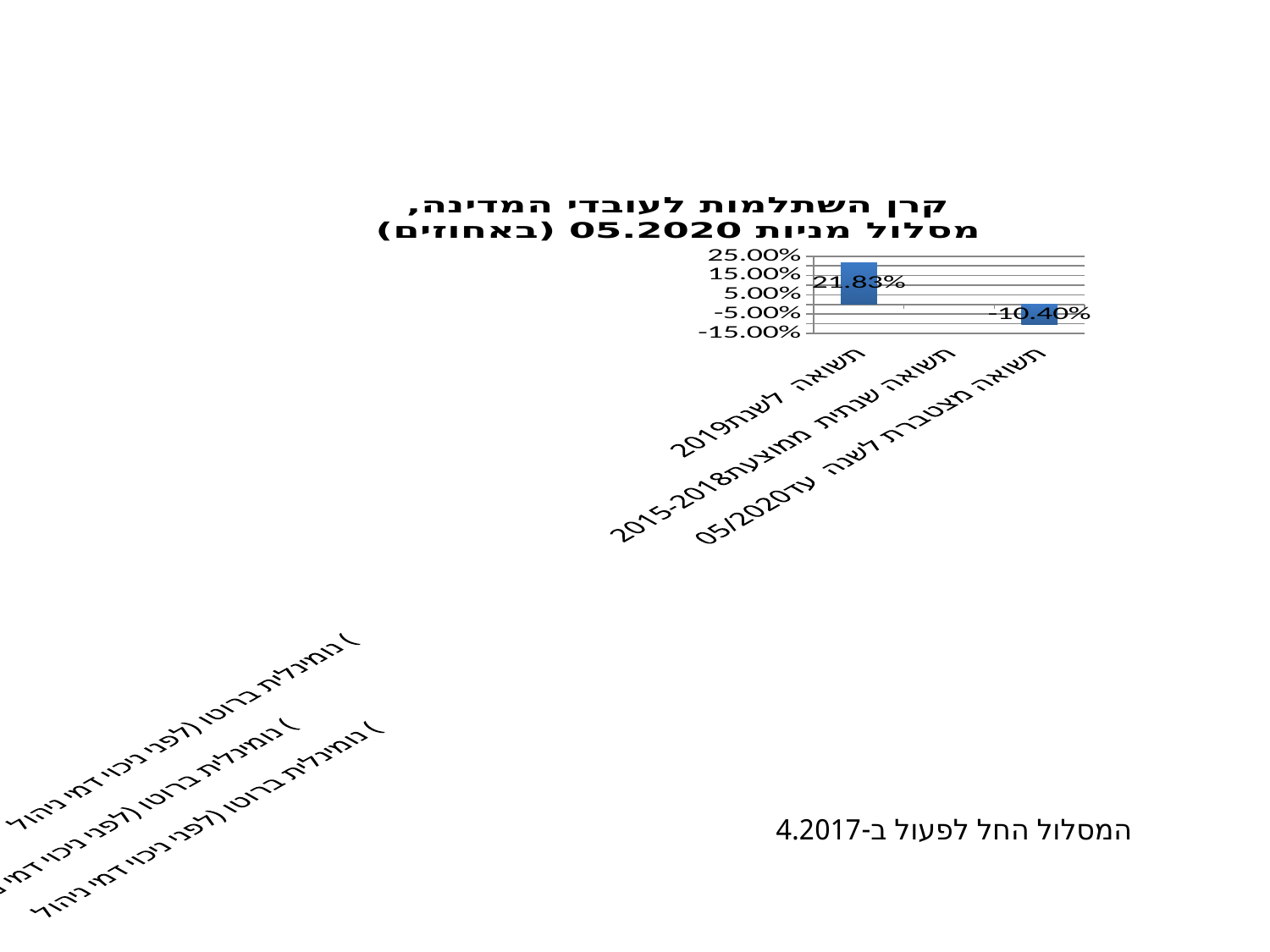
Is the value for תשואה מצטברת לשנה עד 05/2020 greater or less than -5.00%? less Which category has the lowest value in the chart? תשואה מצטברת לשנה עד 05/2020 What kind of chart is shown on the slide? bar chart What is the title of the chart? קרן השתלמות לעובדי המדינה, מסלול מניות 05.2020 (באחוזים) Which is larger: the value for תשואה לשנת 2019 or the value for תשואה מצטברת לשנה עד 05/2020? תשואה לשנת 2019 Is the value for תשואה לשנת 2019 greater or less than 15.00%? greater What is the difference between the value for תשואה לשנת 2019 and the value for תשואה מצטברת לשנה עד 05/2020? 32.23 percentage points What is the value shown for תשואה לשנת 2019? 21.83% How many categories are labelled on the x axis of the chart? 3 Which category on the x axis has no bar plotted? תשואה שנתית ממוצעת 2015-2018 Which category has the highest value in the chart? תשואה לשנת 2019 What is the value shown for תשואה מצטברת לשנה עד 05/2020? -10.40%